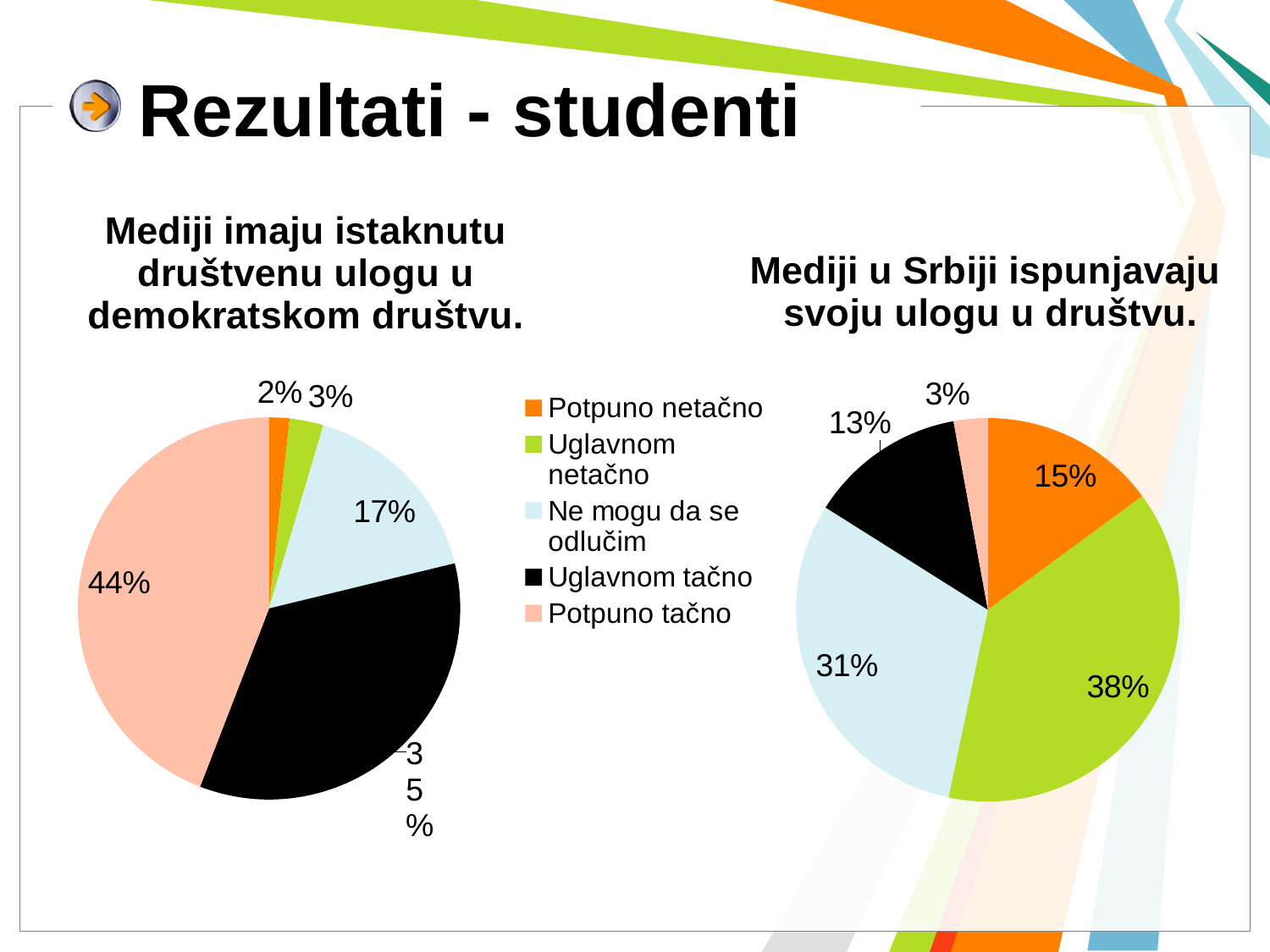
In the right pie chart ("Mediji u Srbiji ispunjavaju svoju ulogu u društvu."), what is the difference between the "Uglavnom netačno" and "Ne mogu da se odlučim" shares? 7% In the right pie chart ("Mediji u Srbiji ispunjavaju svoju ulogu u društvu."), what percentage is shown for "Uglavnom netačno"? 38% In the left pie chart ("Mediji imaju istaknutu društvenu ulogu u demokratskom društvu."), which category has the smallest share? Potpuno netačno In the left pie chart ("Mediji imaju istaknutu društvenu ulogu u demokratskom društvu."), what is the difference between the "Potpuno tačno" and "Uglavnom tačno" shares? 9% In the left pie chart ("Mediji imaju istaknutu društvenu ulogu u demokratskom društvu."), what percentage is shown for "Potpuno tačno"? 44% In the left pie chart ("Mediji imaju istaknutu društvenu ulogu u demokratskom društvu."), what percentage is shown for "Ne mogu da se odlučim"? 17% In the right pie chart ("Mediji u Srbiji ispunjavaju svoju ulogu u društvu."), which category has the smallest share? Potpuno tačno What type of chart is used on this slide? Pie chart In the right pie chart ("Mediji u Srbiji ispunjavaju svoju ulogu u društvu."), what percentage is shown for "Potpuno netačno"? 15% How many categories does the shared legend list? 5 In the left pie chart ("Mediji imaju istaknutu društvenu ulogu u demokratskom društvu."), which category has the largest share? Potpuno tačno In the right pie chart ("Mediji u Srbiji ispunjavaju svoju ulogu u društvu."), which is larger: "Ne mogu da se odlučim" or "Uglavnom tačno"? Ne mogu da se odlučim